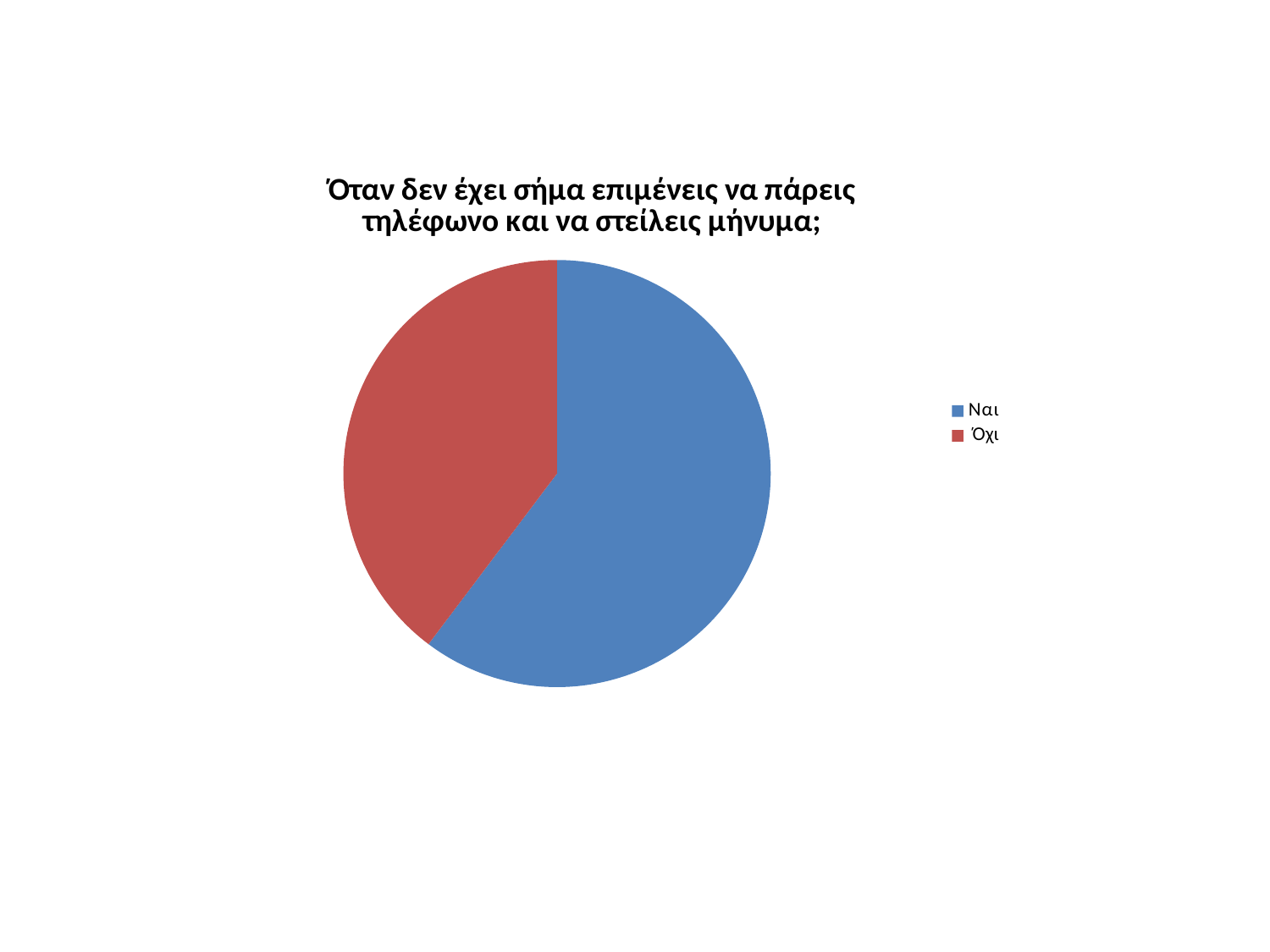
How many slices does the pie chart have? 2 Does the Ναι slice take up more or less than half of the pie? more Which category has the largest slice in the pie chart? Ναι What kind of chart is shown on the slide? pie chart What is the title of the pie chart? Όταν δεν έχει σήμα επιμένεις να πάρεις τηλέφωνο και να στείλεις μήνυμα; Which slice is larger, Ναι or Όχι? Ναι What colour is the Όχι slice in the pie chart? red How many entries does the legend of the pie chart list? 2 Which category has the smallest slice in the pie chart? Όχι